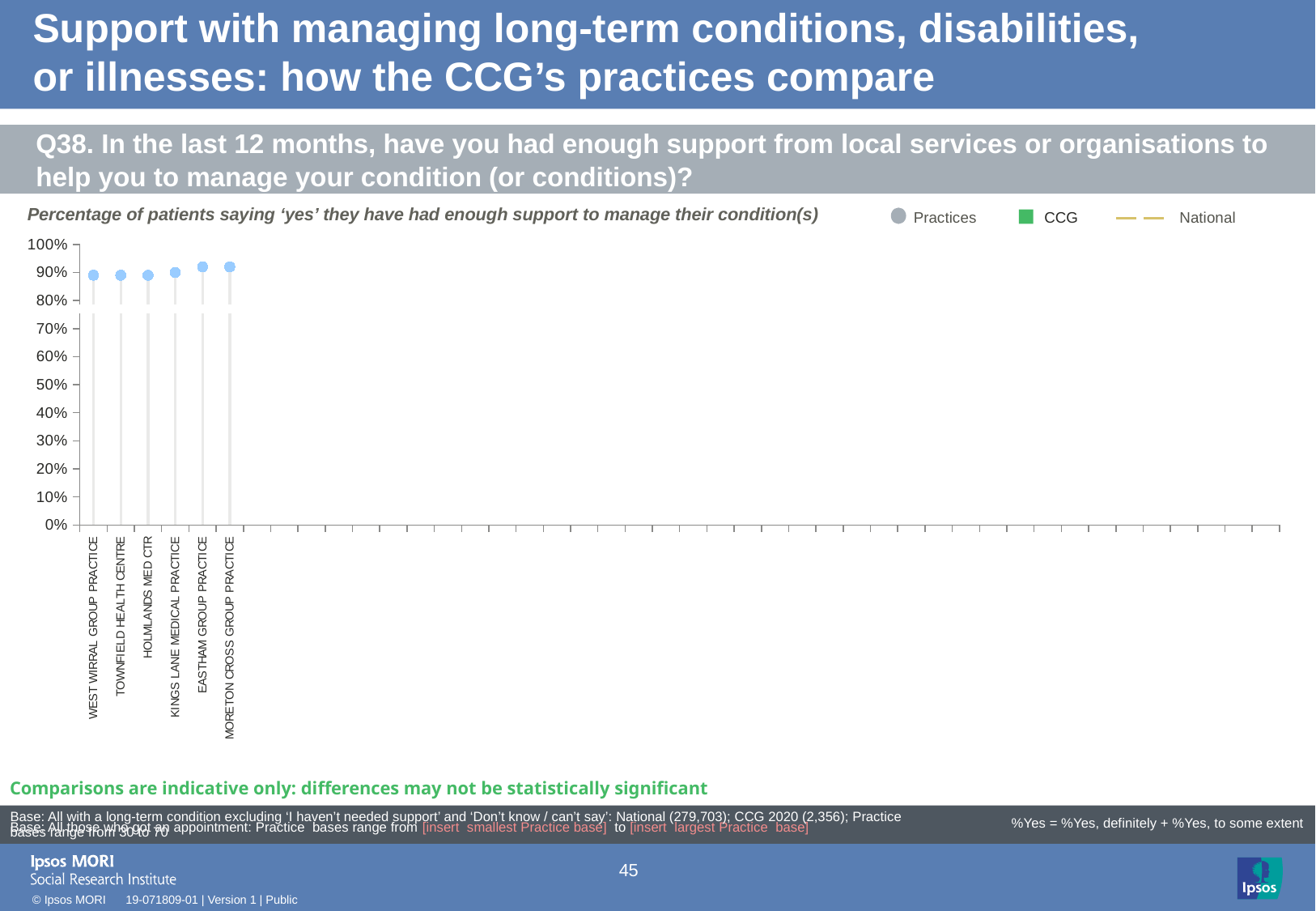
Is the value for MORETON CROSS GROUP PRACTICE greater or less than 100%? less Is the value for TOWNFIELD HEALTH CENTRE greater or less than 60%? greater Is the value for HOLMLANDS MED CTR greater or less than 50%? greater How many series does the chart legend list? 3 How many practices are plotted on the chart? 6 Which has the higher value, MORETON CROSS GROUP PRACTICE or TOWNFIELD HEALTH CENTRE? MORETON CROSS GROUP PRACTICE What is the highest value shown on the y axis? 100% Do the plotted values generally rise or fall from left to right across the practices? rise Which series does the chart legend list? Practices, CCG, National Which practice is plotted first (leftmost) on the x axis? WEST WIRRAL GROUP PRACTICE